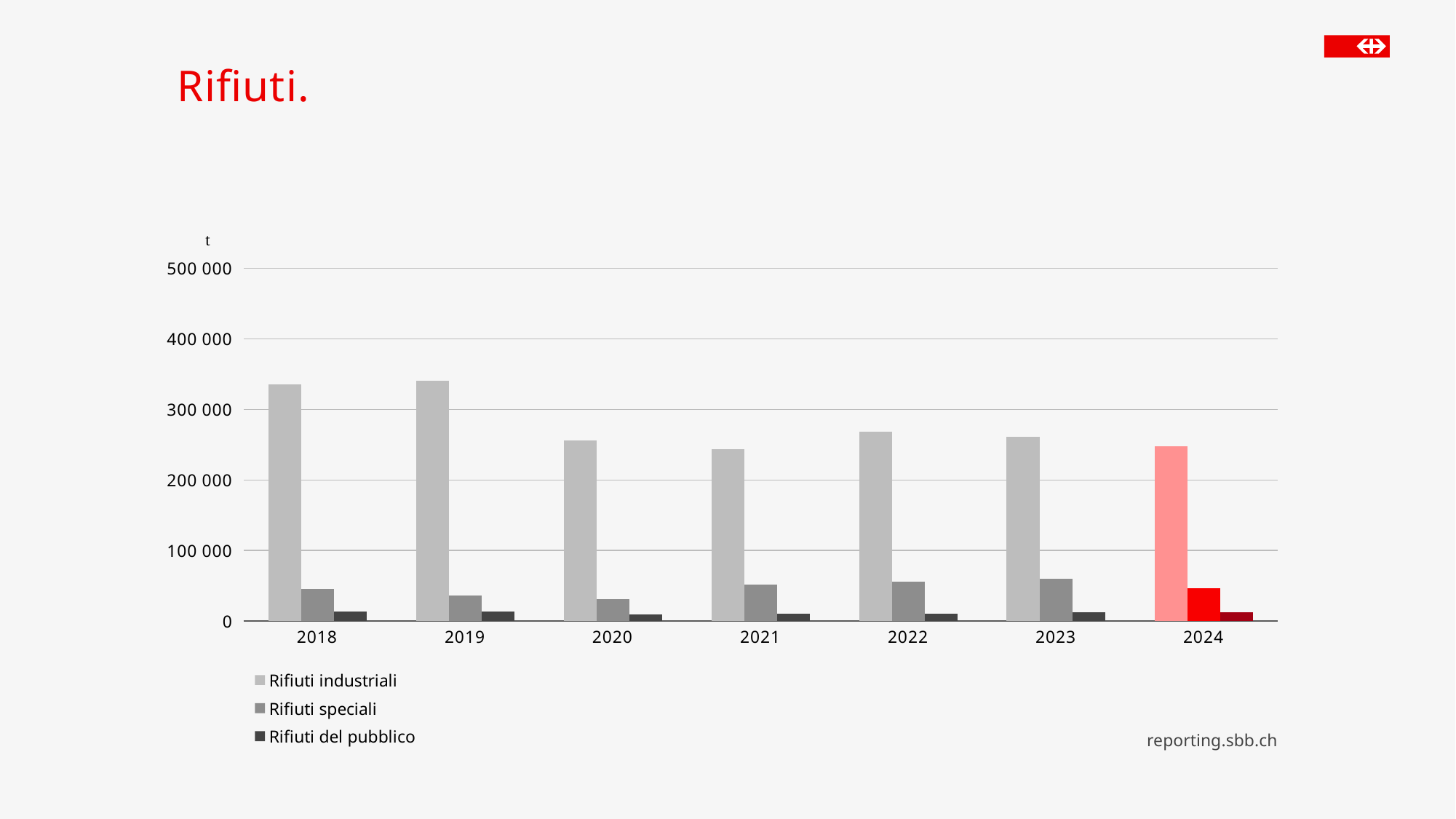
Is the value for Rifiuti industriali in 2021 greater or less than 300 000? less How many series does the legend list? 3 How many years are shown on the x axis? 7 Is the value for Rifiuti industriali in 2024 greater or less than 200 000? greater What kind of chart is shown on the slide? bar chart Which is larger, Rifiuti industriali in 2019 or in 2020? 2019 Which year has the lowest value for Rifiuti speciali? 2020 What unit is shown on the y axis? t Which year has the highest value for Rifiuti speciali? 2023 Is the value for Rifiuti industriali in 2018 greater or less than 300 000? greater Which series has the largest values in every year? Rifiuti industriali